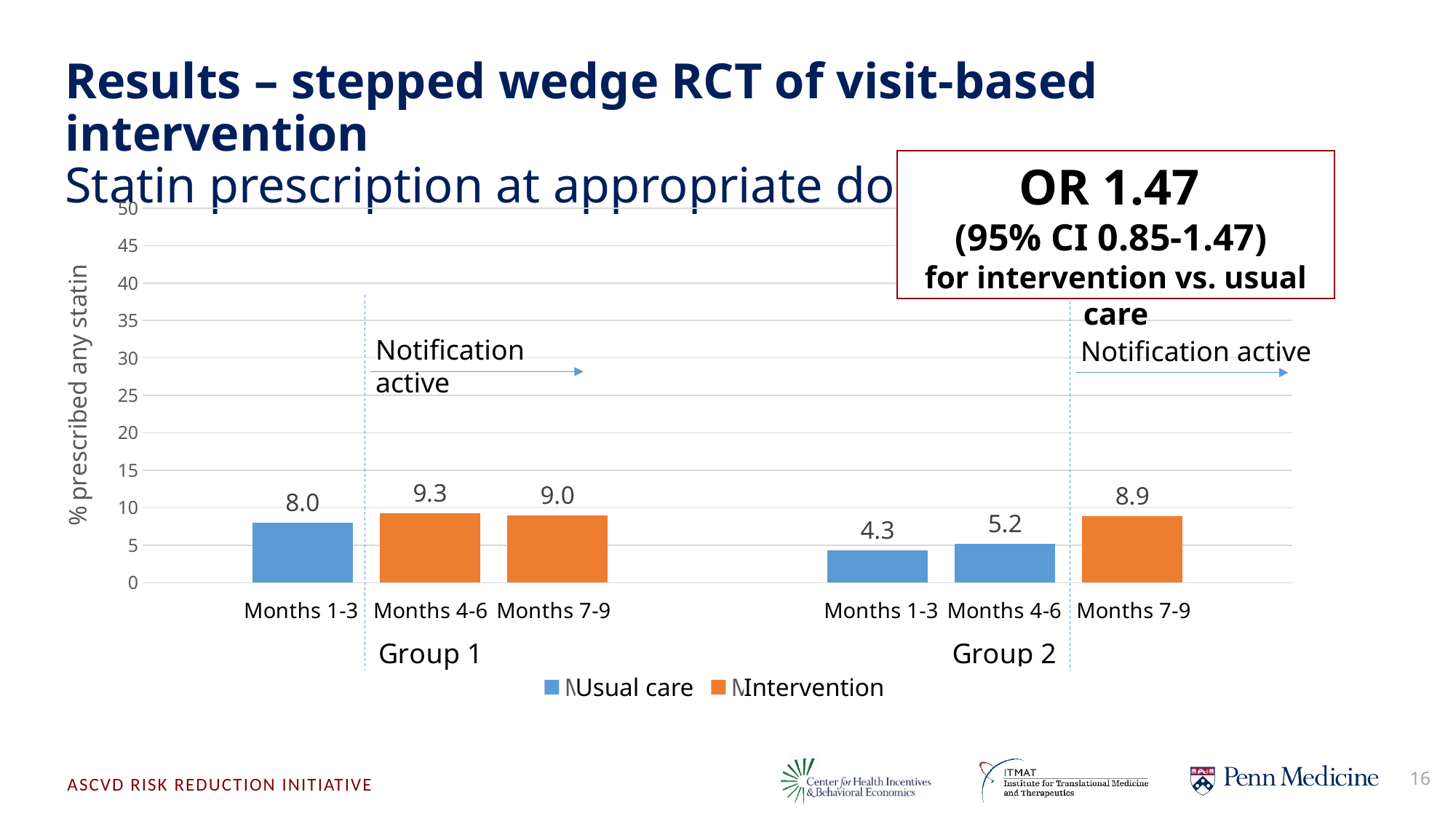
What is the difference between the Months 7-9 and Months 4-6 values in Group 2? 3.7 What is the difference between the Months 4-6 and Months 1-3 values in Group 1? 1.3 How many series does the legend list? 2 Which bar has the highest value on the chart? Months 4-6, Group 1 How many bars are plotted on the chart? 6 What is the label of the y axis? % prescribed any statin Which bar has the lowest value on the chart? Months 1-3, Group 2 What kind of chart is shown on the slide? Bar chart What is the value for Months 7-9 in Group 2? 8.9 What is the value for Months 4-6 in Group 2? 5.2 Which is larger: Months 1-3 in Group 1 or Months 1-3 in Group 2? Months 1-3 in Group 1 What is the value for Months 1-3 in Group 1? 8.0